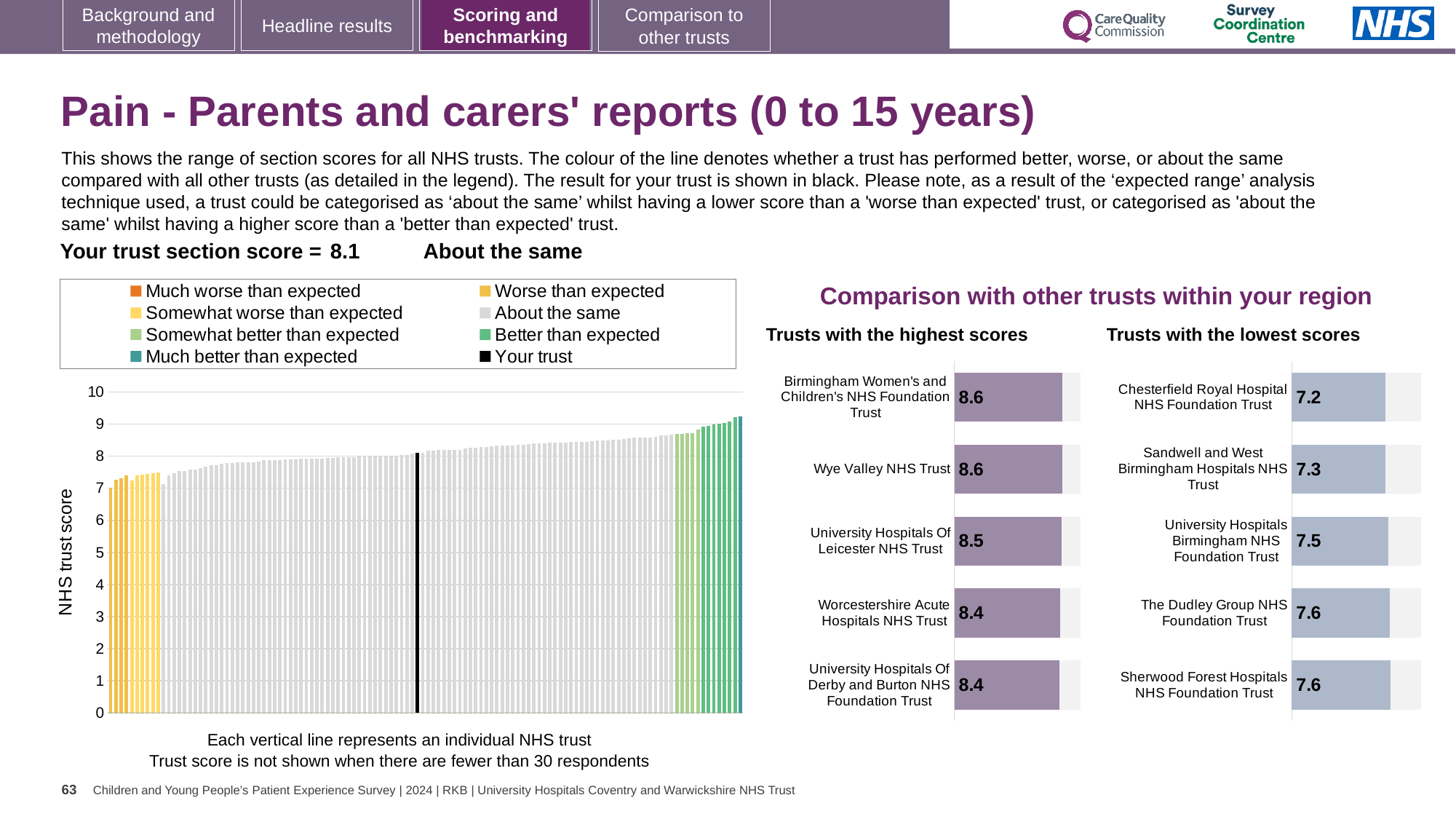
How many trusts are shown in the 'Trusts with the highest scores' chart? 5 In the large chart on the left, do the trust scores rise or fall from left to right? Rise In the 'Trusts with the lowest scores' chart, which has the higher score: Sandwell and West Birmingham Hospitals NHS Trust or The Dudley Group NHS Foundation Trust? The Dudley Group NHS Foundation Trust In the 'Trusts with the lowest scores' chart, which trust has the lowest score? Chesterfield Royal Hospital NHS Foundation Trust In the 'Trusts with the highest scores' chart, what is the score for University Hospitals Of Leicester NHS Trust? 8.5 What kind of chart is the large chart on the left showing the range of section scores for all NHS trusts? Bar chart In the 'Trusts with the lowest scores' chart, what is the score for University Hospitals Birmingham NHS Foundation Trust? 7.5 In the 'Trusts with the highest scores' chart, what is the difference between the score for Birmingham Women's and Children's NHS Foundation Trust and the score for Worcestershire Acute Hospitals NHS Trust? 0.2 In the 'Trusts with the lowest scores' chart, what is the difference between the score for Sherwood Forest Hospitals NHS Foundation Trust and the score for Chesterfield Royal Hospital NHS Foundation Trust? 0.4 In the 'Trusts with the highest scores' chart, what is the score for Wye Valley NHS Trust? 8.6 In the 'Trusts with the lowest scores' chart, what is the score for Chesterfield Royal Hospital NHS Foundation Trust? 7.2 How many entries does the legend of the large chart on the left list? 8